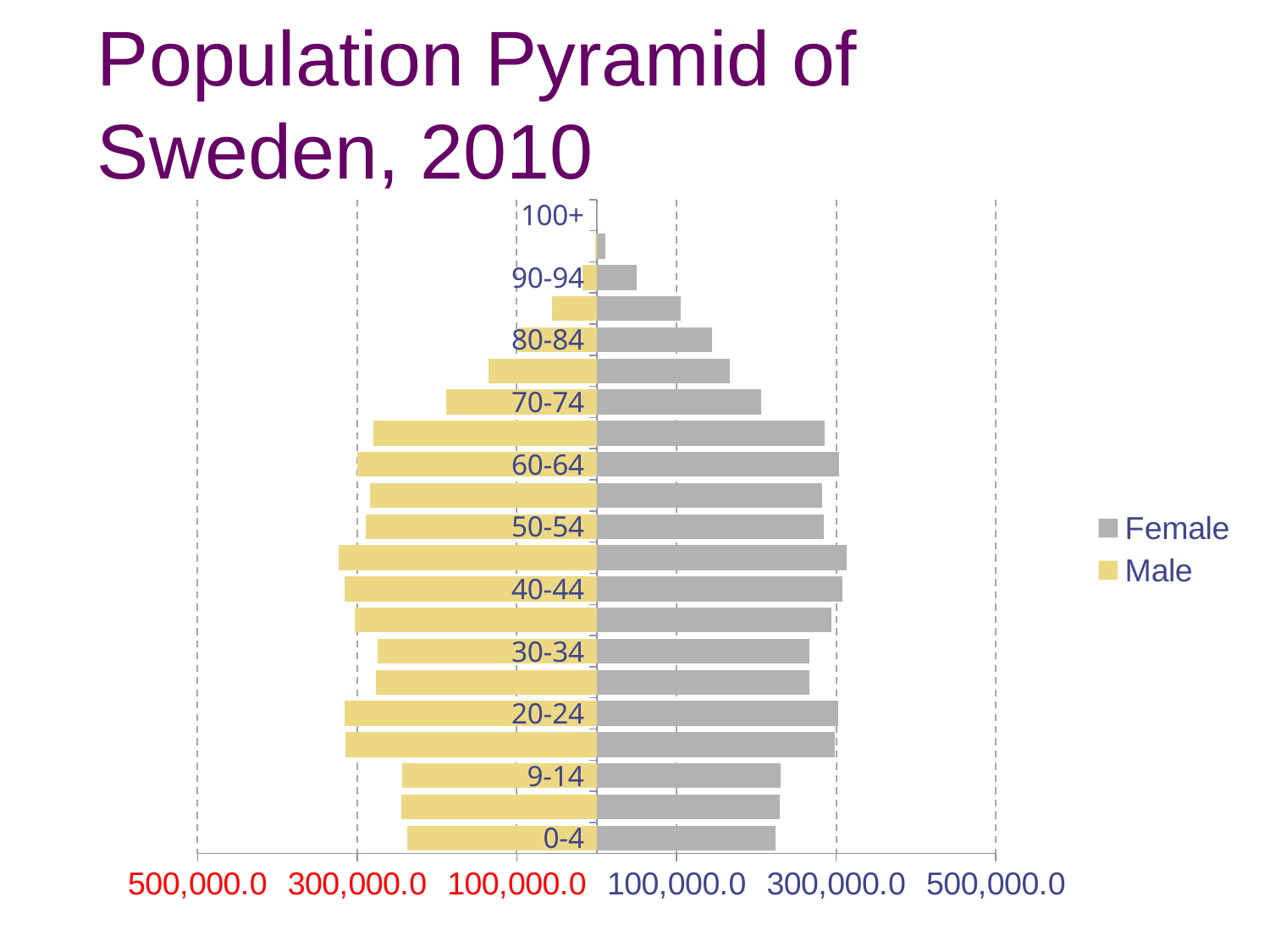
For the 90-94 age group, which is larger, the Female value or the Male value? Female What kind of chart is shown on the slide? bar chart Which age group has the smallest Female value? 100+ How many series does the legend list? 2 Is the Male value for the 70-74 age group greater or less than 100,000.0? greater Is the Female value for the 0-4 age group greater or less than 300,000.0? less Is the Female value for the 80-84 age group greater or less than 100,000.0? greater Moving from the 60-64 age group up to the 100+ age group, do the Female bars get longer or shorter? shorter Which colour represents the Male series? yellow What are the two series named in the legend? Female and Male